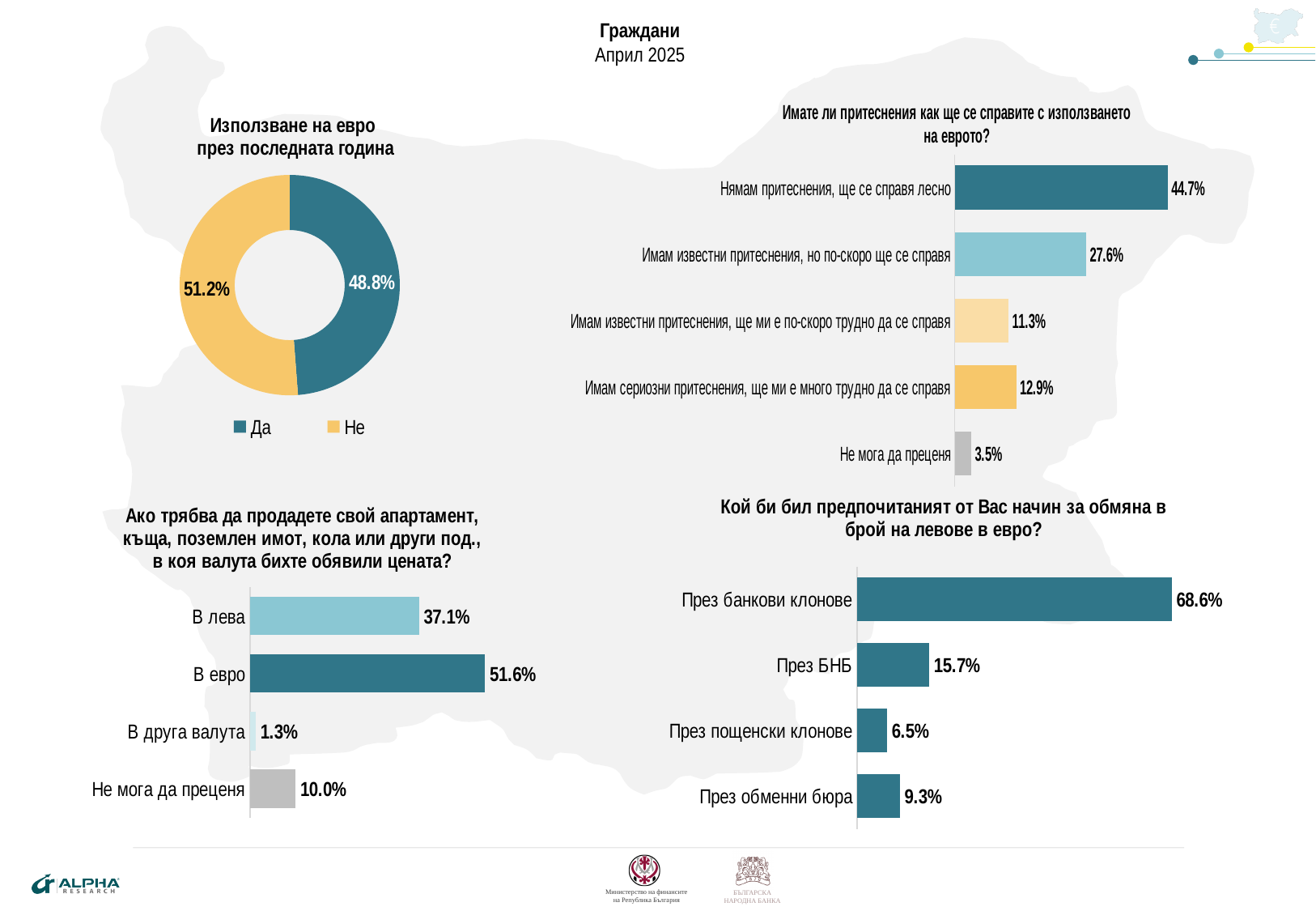
In the chart 'Кой би бил предпочитаният от Вас начин за обмяна в брой на левове в евро?', what is the value for 'През БНБ'? 15.7% In the donut chart 'Използване на евро през последната година', which slice is larger, 'Да' or 'Не'? Не In the chart 'Имате ли притеснения как ще се справите с използването на еврото?', how many categories are shown? 5 In the chart 'Ако трябва да продадете свой апартамент, къща, поземлен имот, кола или други под., в коя валута бихте обявили цената?', which category has the highest value? В евро What kind of chart is 'Използване на евро през последната година'? Donut (pie) chart In the chart 'Имате ли притеснения как ще се справите с използването на еврото?', what is the difference between 'Имам сериозни притеснения, ще ми е много трудно да се справя' and 'Имам известни притеснения, ще ми е по-скоро трудно да се справя'? 1.6% In the chart 'Имате ли притеснения как ще се справите с използването на еврото?', what is the value for 'Нямам притеснения, ще се справя лесно'? 44.7% In the chart 'Кой би бил предпочитаният от Вас начин за обмяна в брой на левове в евро?', what is the difference between 'През банкови клонове' and 'През БНБ'? 52.9% In the donut chart 'Използване на евро през последната година', what is the value for 'Да'? 48.8% In the chart 'Имате ли притеснения как ще се справите с използването на еврото?', which category has the lowest value? Не мога да преценя In the chart 'Ако трябва да продадете свой апартамент, къща, поземлен имот, кола или други под., в коя валута бихте обявили цената?', what is the value for 'В друга валута'? 1.3% What kind of chart is 'Кой би бил предпочитаният от Вас начин за обмяна в брой на левове в евро?'? Bar chart